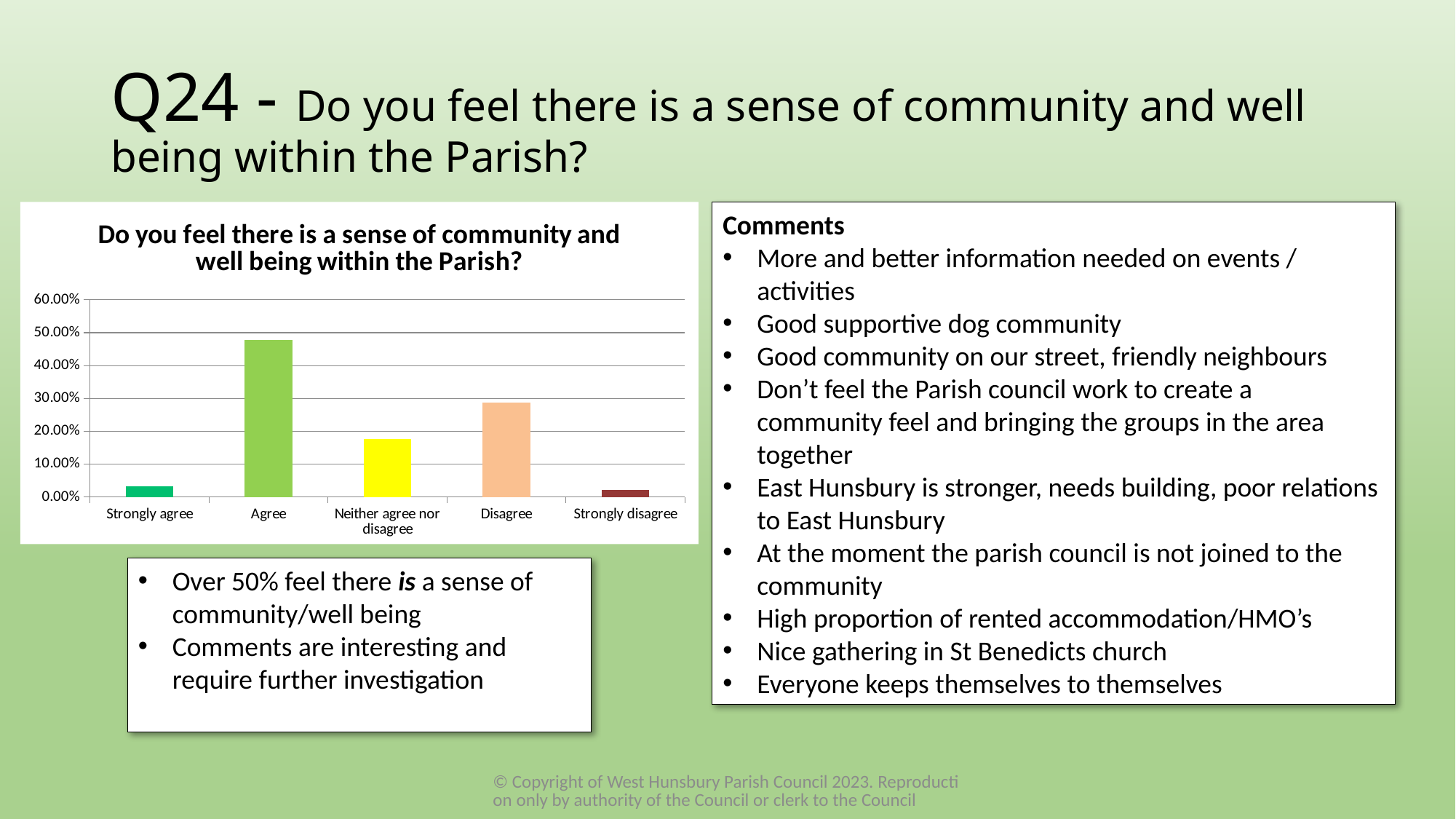
Is the value for Agree greater or less than 40.00%? greater Which is larger, the value for Disagree or the value for Neither agree nor disagree? Disagree Is the value for Neither agree nor disagree greater or less than 20.00%? less What type of chart is shown on the slide? Bar chart Is the value for Agree greater or less than 50.00%? less Which is larger, the value for Agree or the value for Disagree? Agree What is the title of the chart? Do you feel there is a sense of community and well being within the Parish? Which response category has the highest value in the chart? Agree How many response categories are shown on the x axis of the chart? 5